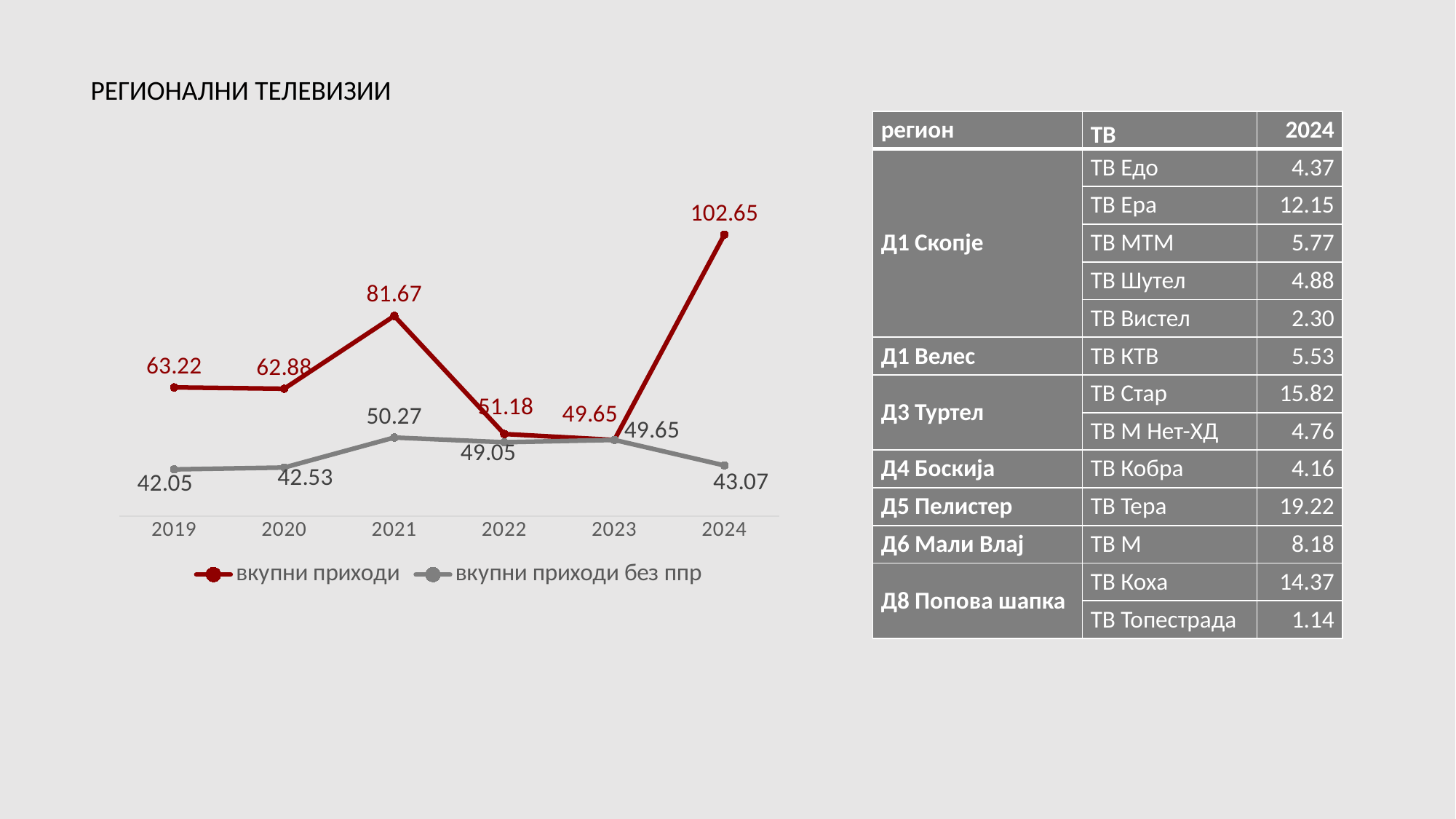
How many years are plotted on the x axis of the chart? 6 In which year is вкупни приходи highest? 2024 What colour is the line for вкупни приходи без ппр? gray What is the value of вкупни приходи без ппр in 2021? 50.27 What type of chart is shown on the slide? line chart How many series does the chart legend list? 2 What is the difference between вкупни приходи and вкупни приходи без ппр in 2024? 59.58 Does вкупни приходи rise or fall from 2021 to 2022? fall In which year is вкупни приходи без ппр lowest? 2019 Which series has the larger value in 2021, вкупни приходи or вкупни приходи без ппр? вкупни приходи What is the value of вкупни приходи in 2022? 51.18 What is the value of вкупни приходи in 2024? 102.65